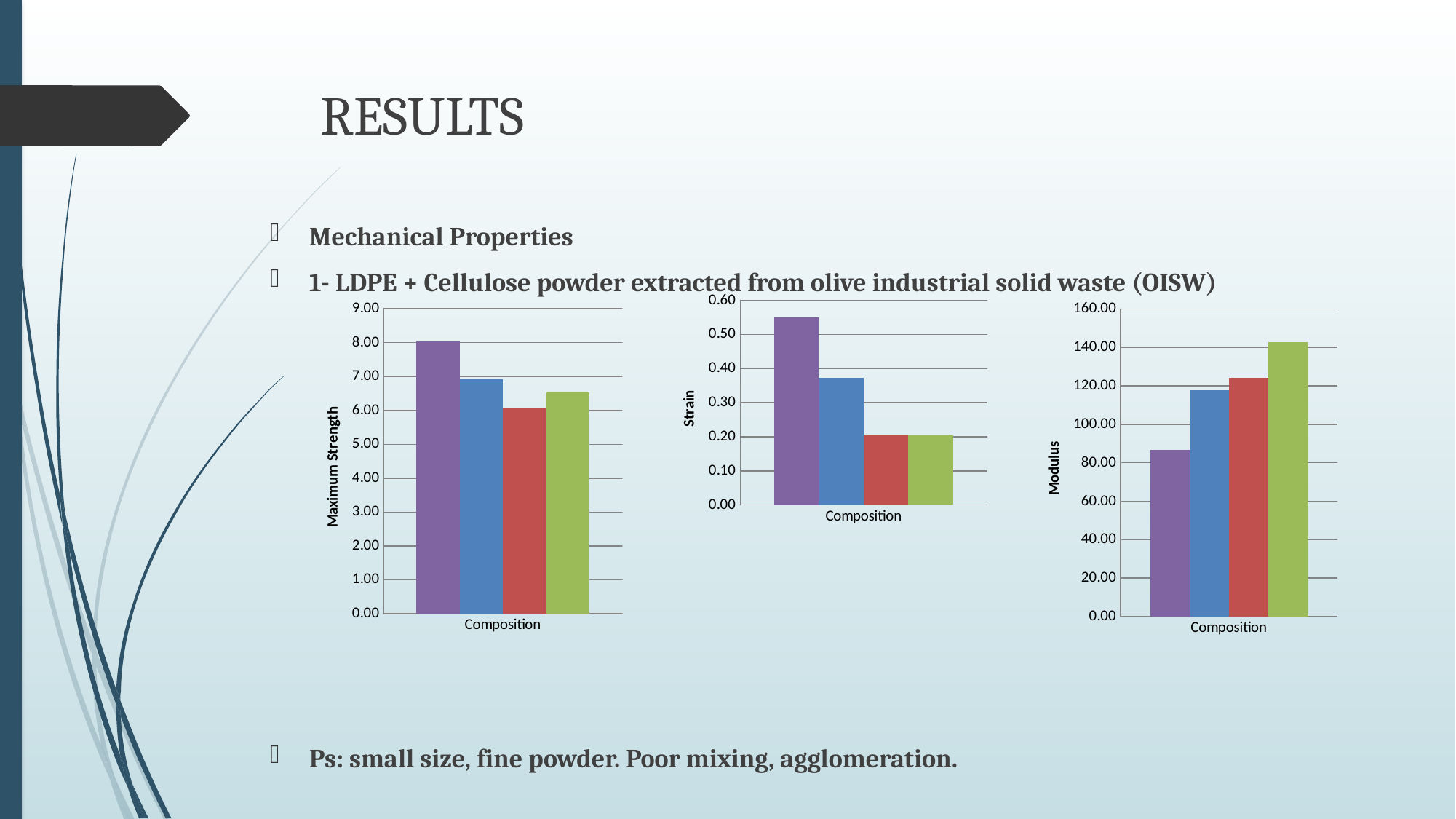
What kind of chart is the Maximum Strength chart on the left of the slide? bar chart In the Modulus chart on the right, is the value of the purple bar greater or less than 100.00? less In the Modulus chart on the right, do the bar values rise or fall from left to right? rise In the Maximum Strength chart on the left, is the value of the purple bar greater or less than 7.00? greater In the Strain chart in the middle, which coloured bar is the highest? purple In the Modulus chart on the right, which coloured bar is the highest? green In the Maximum Strength chart on the left, which coloured bar is the lowest? red In the Maximum Strength chart on the left, which coloured bar is the highest? purple What is the x-axis label of the Modulus chart on the right? Composition How many bars are plotted in the Strain chart in the middle of the slide? 4 In the Strain chart in the middle, is the value of the blue bar greater or less than 0.40? less In the Modulus chart on the right, which coloured bar is the lowest? purple